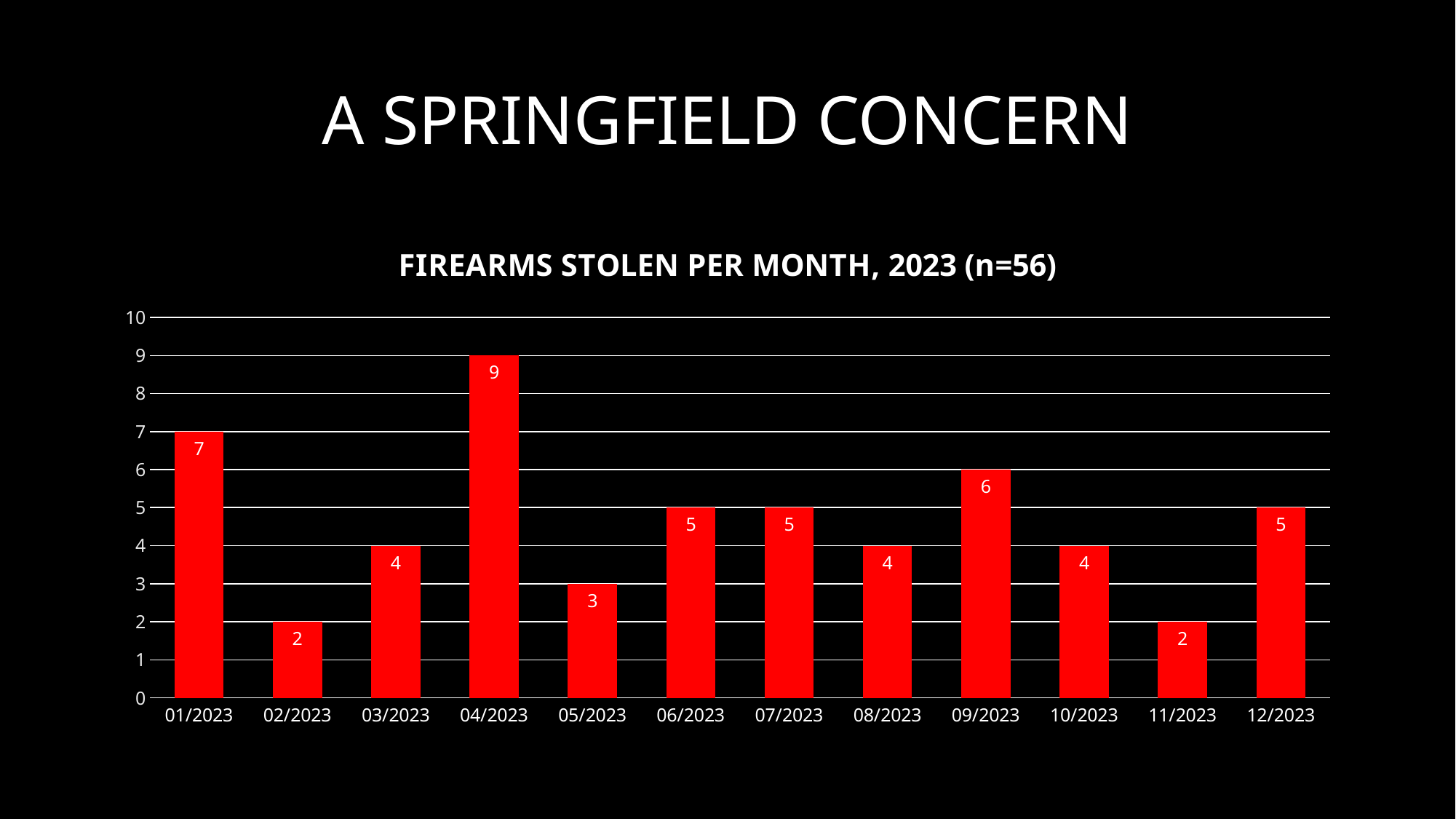
Is the value for 01/2023 greater or less than 5? greater What colour are the bars in the chart? Red Which month has the highest number of firearms stolen? 04/2023 What is the difference between the values for 04/2023 and 02/2023? 7 What is the value shown for 09/2023? 6 How many firearms were stolen in 04/2023? 9 Which is larger, the value for 09/2023 or the value for 10/2023? 09/2023 What kind of chart is shown on the slide? Bar chart What is the title of the chart? FIREARMS STOLEN PER MONTH, 2023 (n=56) What is the difference between the values for 01/2023 and 12/2023? 2 How many months are shown on the x axis? 12 How many firearms were stolen in 05/2023? 3